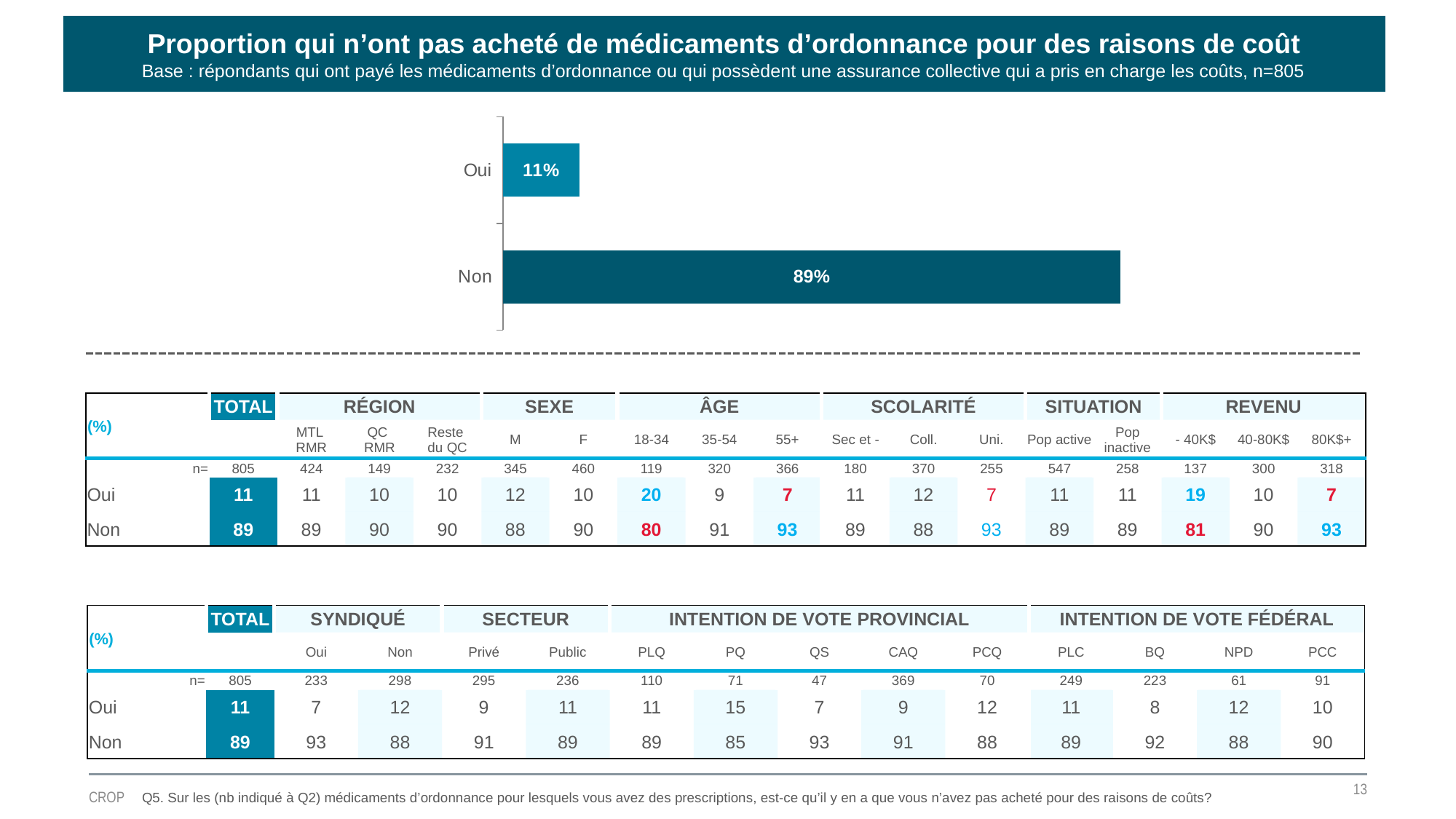
What is the value for "Non" in the bar chart? 89% What kind of chart is shown on the slide? Bar chart Which is larger in the bar chart, the value for "Oui" or the value for "Non"? Non What is the base size (n) stated in the subtitle above the bar chart? n=805 What is the title of the slide containing the bar chart? Proportion qui n’ont pas acheté de médicaments d’ordonnance pour des raisons de coût Which category has the highest value in the bar chart? Non What is the difference between the values for "Non" and "Oui" in the bar chart? 78% What is the total of the two values shown in the bar chart? 100% Which category has the lowest value in the bar chart? Oui How many categories are shown in the bar chart? 2 What is the value for "Oui" in the bar chart? 11%